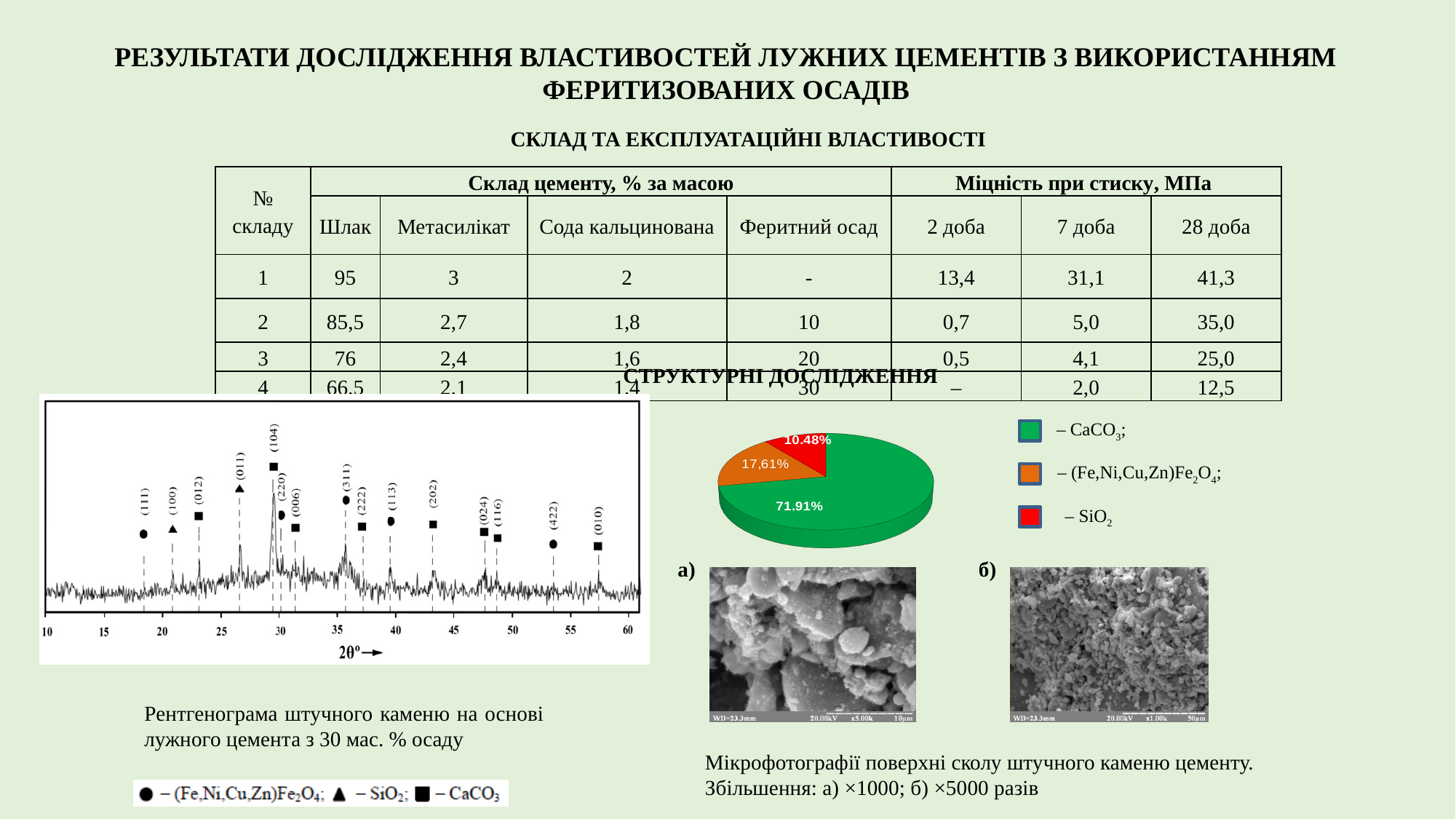
In the pie chart, what share is shown for (Fe,Ni,Cu,Zn)Fe2O4? 17,61% Is the CaCO3 slice in the pie chart greater or less than 50%? greater In the pie chart, what share is shown for CaCO3? 71.91% In the pie chart, which is larger: the slice for (Fe,Ni,Cu,Zn)Fe2O4 or the slice for SiO2? (Fe,Ni,Cu,Zn)Fe2O4 What kind of chart is used to show the phase composition (CaCO3, (Fe,Ni,Cu,Zn)Fe2O4, SiO2)? pie chart How many entries does the legend of the pie chart list? 3 How many slices does the pie chart have? 3 Which component has the smallest slice in the pie chart? SiO2 What colour is the CaCO3 slice in the pie chart? green In the pie chart, what share is shown for SiO2? 10.48% In the pie chart, by how many percentage points does the CaCO3 slice exceed the SiO2 slice? 61.43% Which component has the largest slice in the pie chart? CaCO3